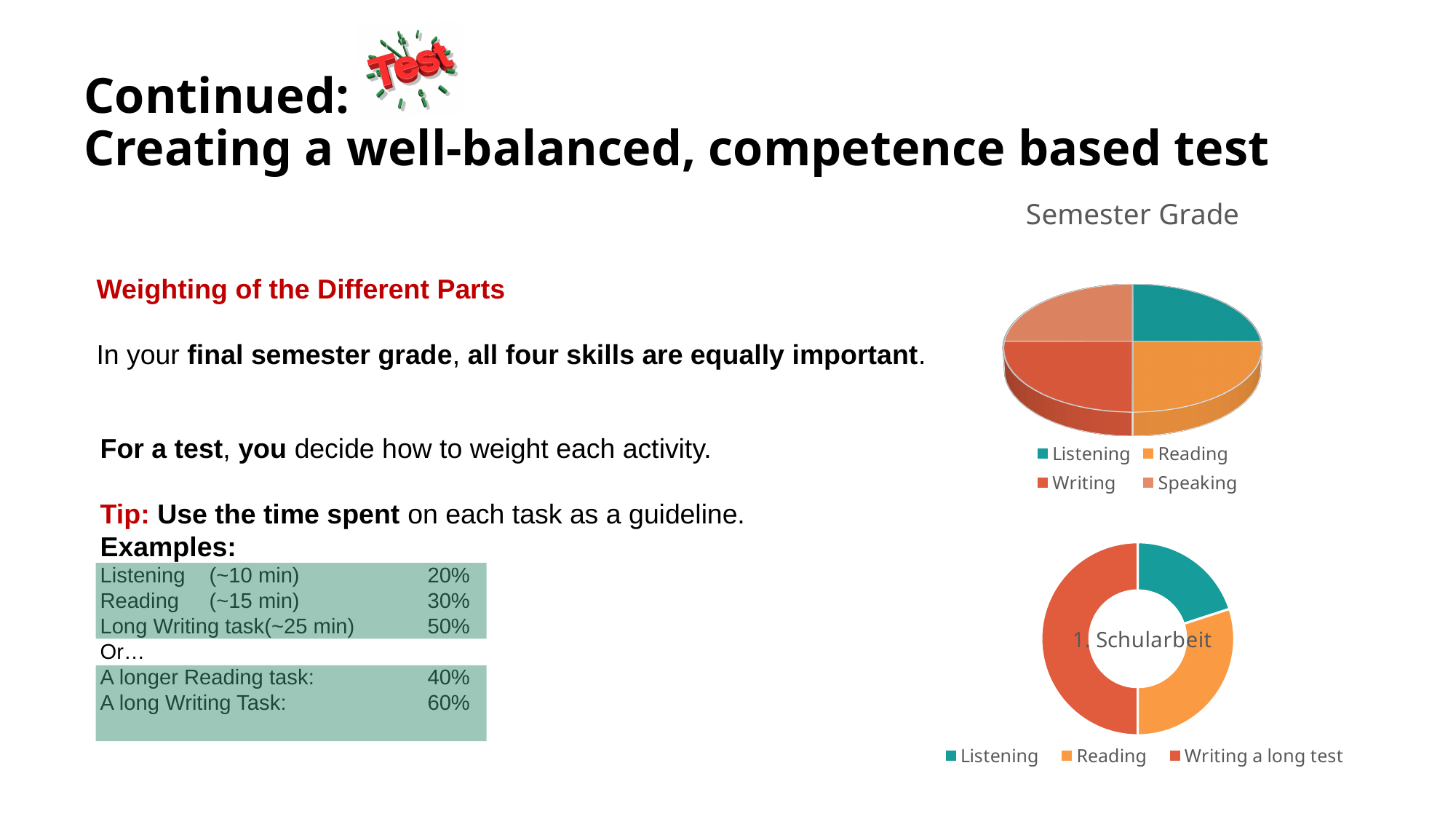
How many categories does the legend of the '1. Schularbeit' chart list? 3 What is the title of the pie chart on the slide? Semester Grade In the '1. Schularbeit' chart, which category has the smallest segment? Listening In the '1. Schularbeit' chart, which segment is larger, Reading or Listening? Reading Which category in the 'Semester Grade' chart is shown in teal? Listening How many segments does the '1. Schularbeit' doughnut chart have? 3 In the '1. Schularbeit' chart, which category has the largest segment? Writing a long test What kind of chart is the 'Semester Grade' chart? Pie chart In the '1. Schularbeit' chart, which segment is larger, Writing a long test or Reading? Writing a long test How many slices does the 'Semester Grade' pie chart have? 4 How many categories does the legend of the 'Semester Grade' chart list? 4 What kind of chart is the '1. Schularbeit' chart? Doughnut chart